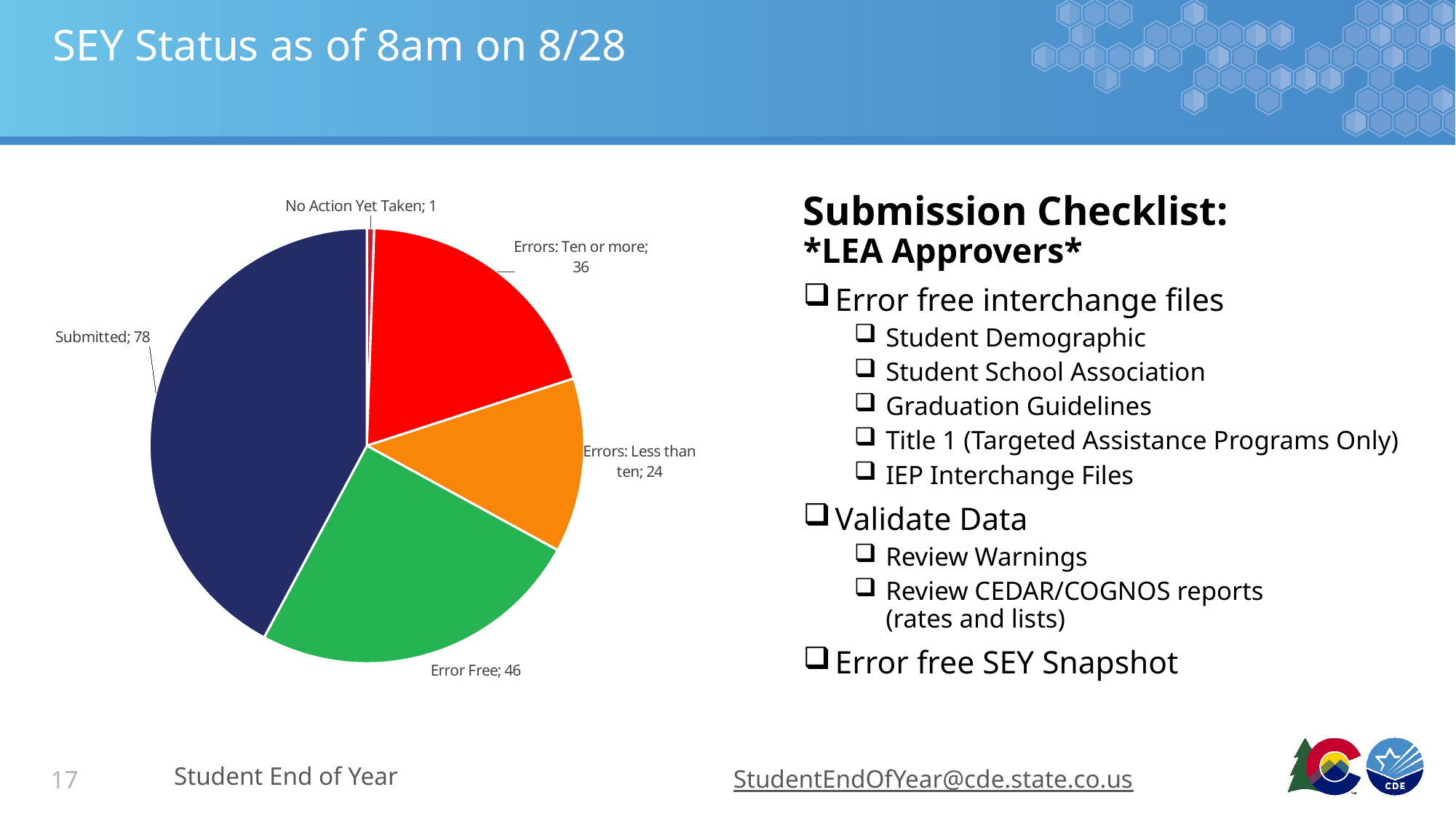
What is the value for Errors: Less than ten in the pie chart? 24 What is the value for No Action Yet Taken in the pie chart? 1 Which is larger in the pie chart: Errors: Ten or more or Errors: Less than ten? Errors: Ten or more Which category has the largest slice in the pie chart? Submitted What kind of chart is shown on the slide? pie chart What is the difference between the Submitted value and the Error Free value? 32 What is the total of all the values shown in the pie chart? 185 What is the value for Error Free in the pie chart? 46 What is the value for Errors: Ten or more in the pie chart? 36 What is the value for Submitted in the pie chart? 78 Which category has the smallest slice in the pie chart? No Action Yet Taken How many categories does the pie chart show? 5